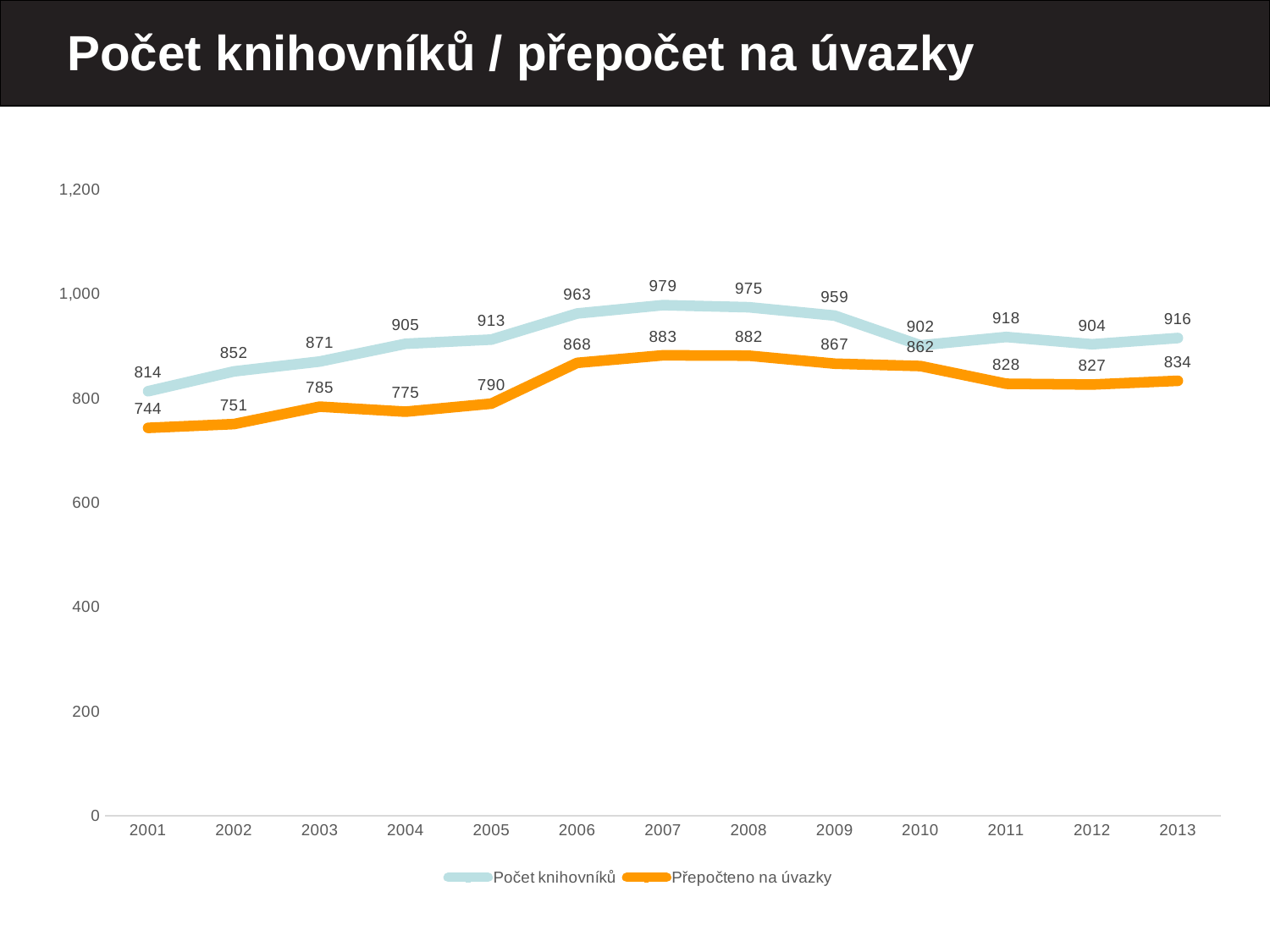
What is the difference between Počet knihovníků and Přepočteno na úvazky in 2013? 82 How many years are shown on the x axis? 13 What is the title of the slide? Počet knihovníků / přepočet na úvazky In which year is Počet knihovníků highest? 2007 Is the value of Přepočteno na úvazky in 2005 greater or less than 800? less Does Počet knihovníků rise or fall from 2001 to 2007? rise How many series does the legend list? 2 What is the value of Přepočteno na úvazky in 2001? 744 What is the value of Počet knihovníků in 2007? 979 In which year is Přepočteno na úvazky lowest? 2001 Which is larger in 2004: Počet knihovníků or Přepočteno na úvazky? Počet knihovníků What kind of chart is shown on the slide? line chart